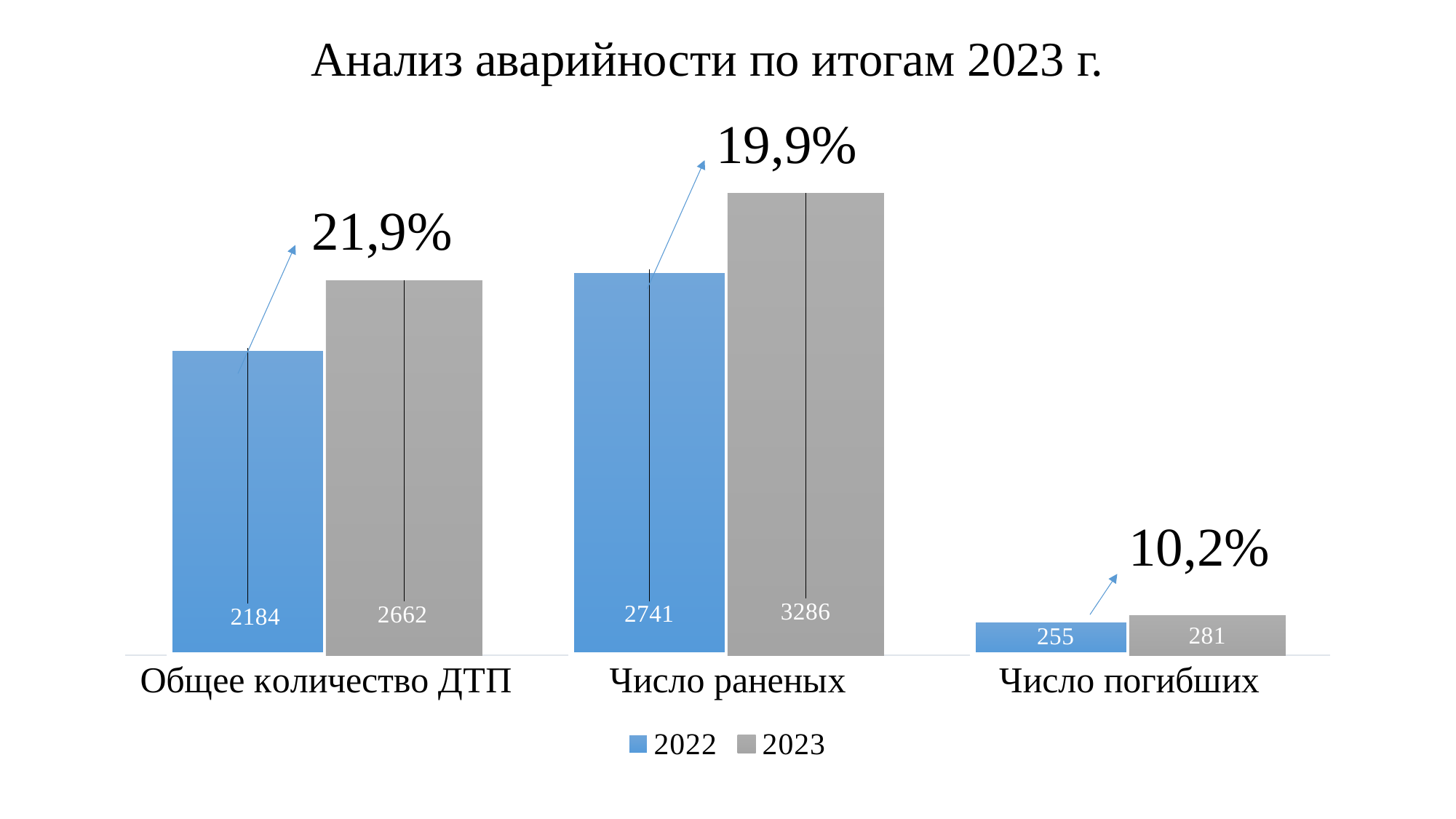
What is the value for 2023 in the category "Число раненых"? 3286 What is the value for 2022 in the category "Общее количество ДТП"? 2184 Which category has the highest value for the 2023 series? Число раненых What kind of chart is shown on the slide? Bar chart What is the difference between the 2023 and 2022 values for "Общее количество ДТП"? 478 How many series does the legend list? 2 What percentage change is annotated above the "Число раненых" bars? 19,9% How many categories are shown on the x axis? 3 What is the value for 2023 in the category "Число погибших"? 281 Which is larger for "Число раненых": the 2022 value or the 2023 value? 2023 Which category has the lowest value for the 2022 series? Число погибших What is the difference between the 2023 and 2022 values for "Число погибших"? 26